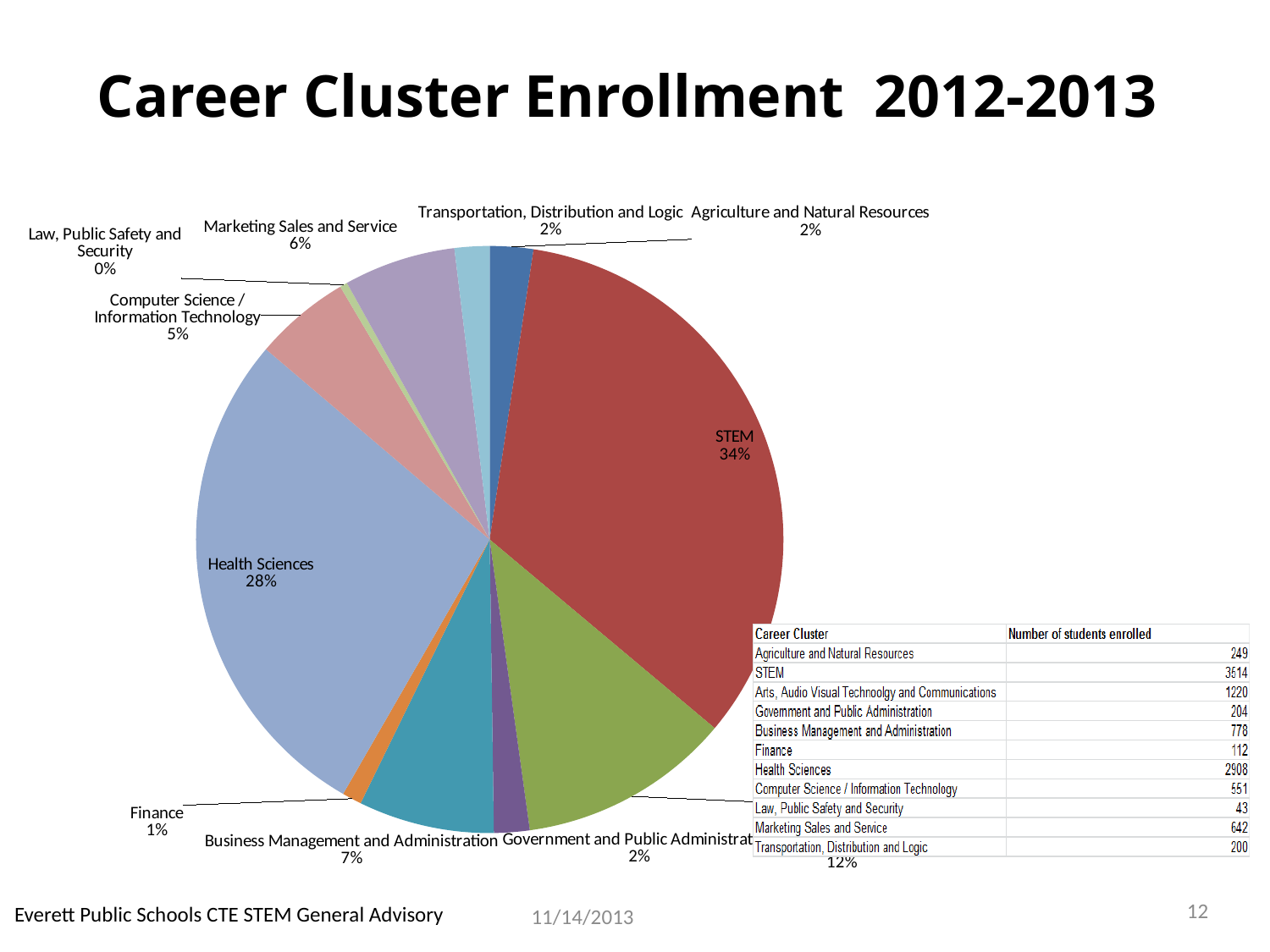
What is the title of the chart on the slide? Career Cluster Enrollment 2012-2013 Which career cluster has the smallest slice of the pie? Law, Public Safety and Security What percentage is shown for Business Management and Administration? 7% What percentage is shown for Marketing Sales and Service? 6% What is the difference in percentage points between STEM and Health Sciences? 6 Which is larger, the slice for Marketing Sales and Service or the slice for Computer Science / Information Technology? Marketing Sales and Service How many career clusters are shown as slices in the pie chart? 11 What kind of chart is shown on the slide? pie chart What percentage is shown for Computer Science / Information Technology? 5% Which career cluster has the largest slice of the pie? STEM What share of the pie does Health Sciences represent? 28% What share of the pie does STEM represent? 34%